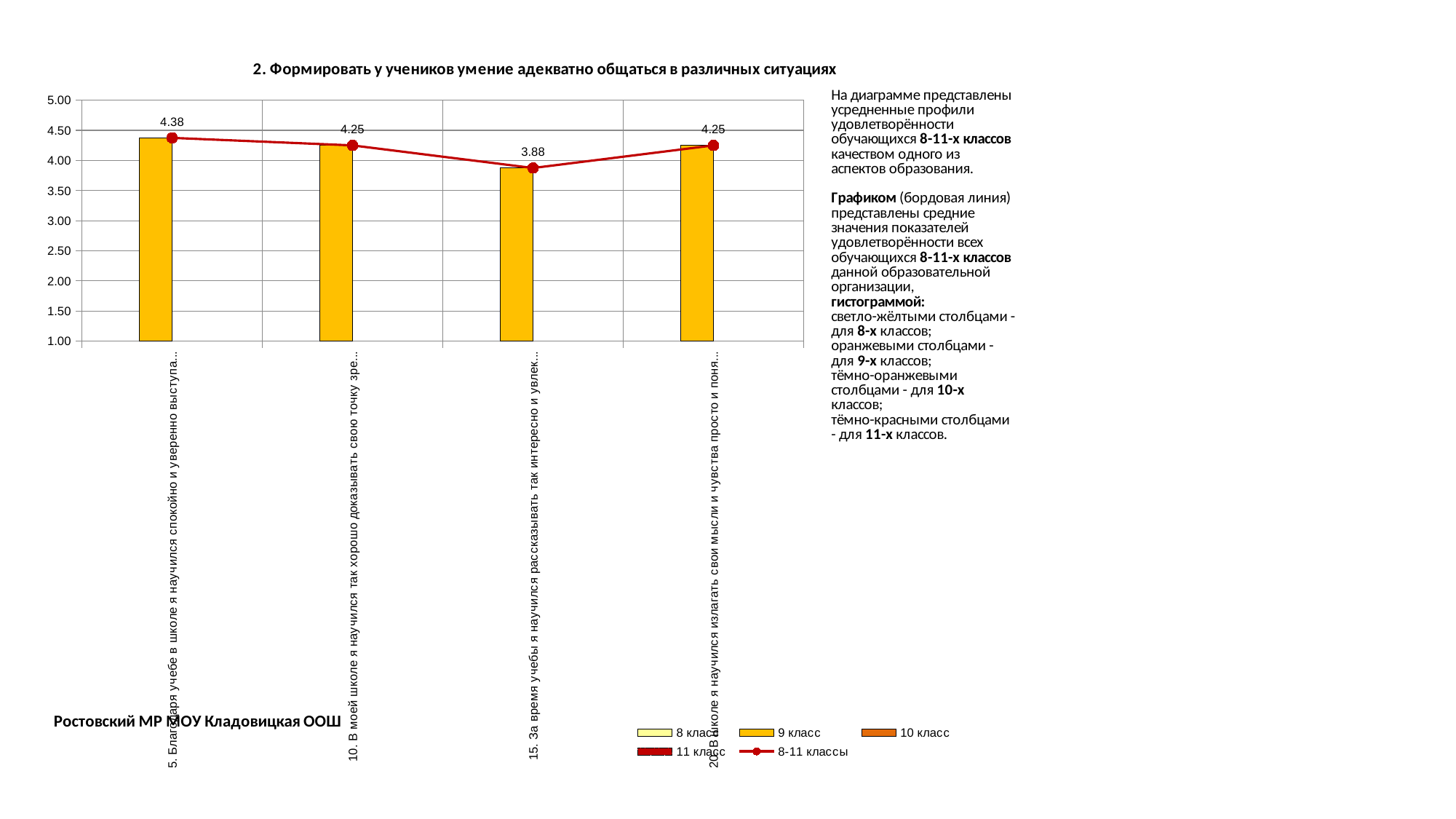
How many series does the legend list? 5 What kind of chart is shown on the slide? A bar chart combined with a line chart Which has the larger value, item 10 or item 15? Item 10 What is the value shown for item 15 ("За время учебы я научился рассказывать так интересно и увлек...")? 3.88 How many categories (items) are plotted on the x axis? 4 Is the value for item 15 greater or less than 4.00? less Which item has the highest value on the chart? Item 5 What is the difference between the values for item 5 and item 15? 0.50 Which item has the lowest value on the chart? Item 15 What is the value shown for item 20 ("В школе я научился излагать свои мысли и чувства просто и поня...")? 4.25 Which legend series is drawn as a line with markers rather than as bars? 8-11 классы What is the value shown for item 5 ("Благодаря учебе в школе я научился спокойно и уверенно выступа...")? 4.38